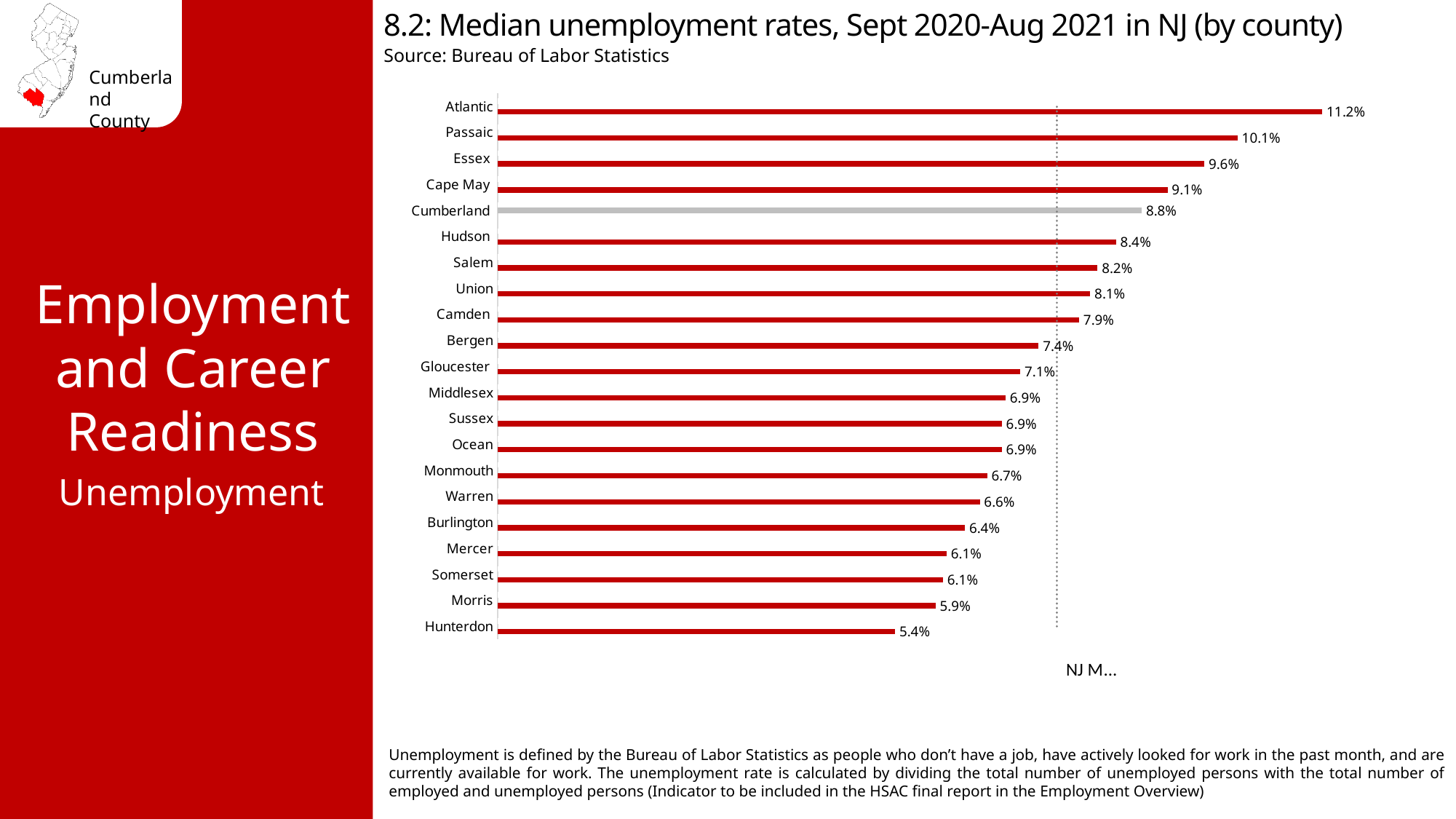
Which county has the lowest median unemployment rate? Hunterdon What is the difference between the median unemployment rates of Cumberland and Cape May counties? 0.3% Which county has a higher median unemployment rate, Passaic or Essex? Passaic Which county's bar is shown in grey rather than red? Cumberland What is the median unemployment rate for Atlantic County? 11.2% Which county has a higher median unemployment rate, Salem or Camden? Salem How many counties are shown in the chart? 21 What type of chart is used to show the median unemployment rates? Bar chart What is the median unemployment rate for Cumberland County? 8.8% What is the median unemployment rate for Hunterdon County? 5.4% Which county has the highest median unemployment rate? Atlantic What is the difference between the median unemployment rates of Atlantic and Hunterdon counties? 5.8%